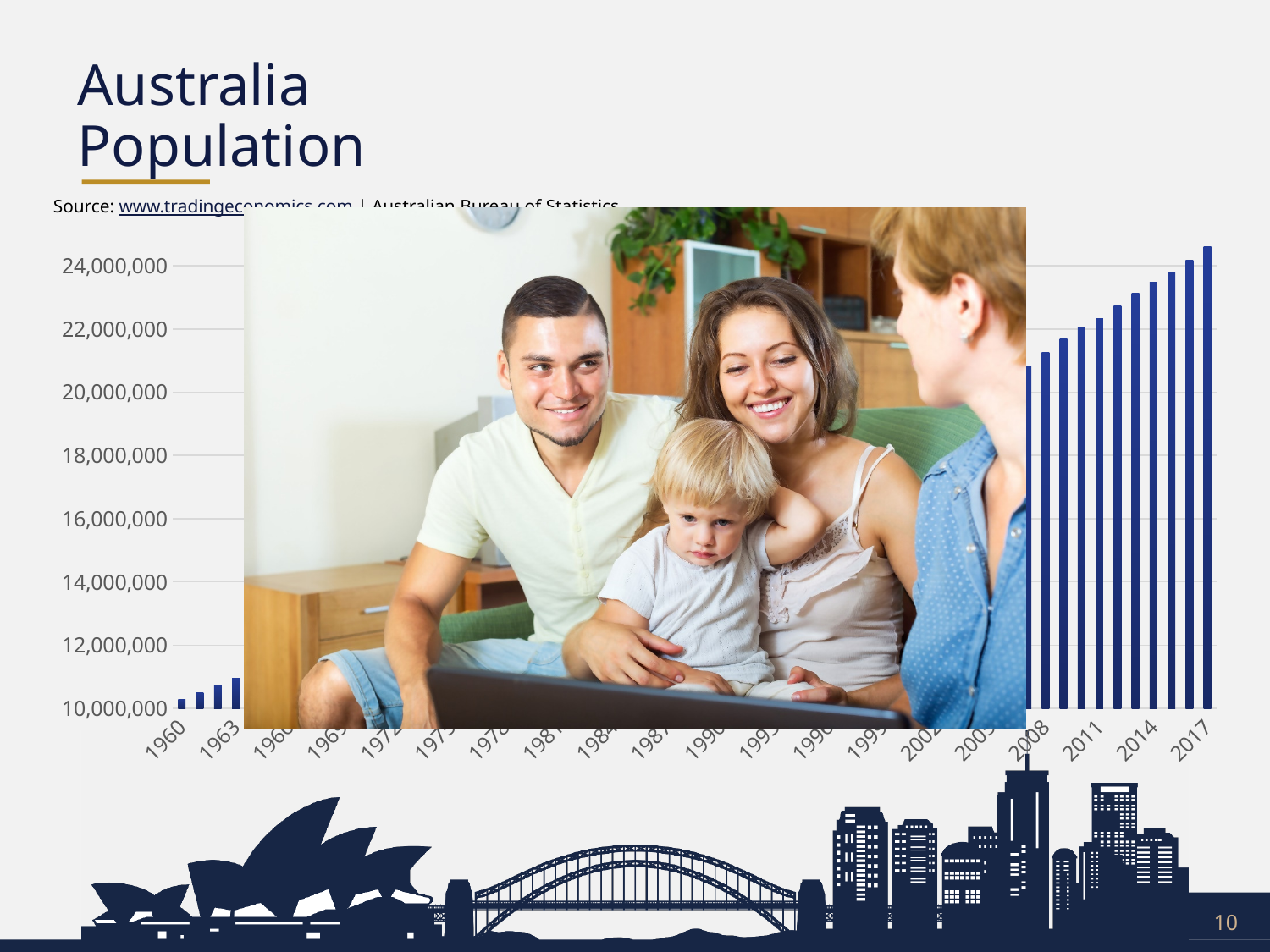
Which is larger, the value for 1960 or the value for 2014? 2014 Which is larger, the value for 2008 or the value for 2017? 2017 Is the value for 2017 greater or less than 24,000,000? greater What is the first year labelled on the x axis? 1960 Is the value for 1960 greater or less than 12,000,000? less What kind of chart is shown on the slide? bar chart What is the highest value labelled on the vertical axis? 24,000,000 Which of the visible years has the highest value? 2017 Is the value for 2008 greater or less than 20,000,000? greater What is the title of the slide's chart? Australia Population Do the values rise or fall from 2008 to 2017 along the x axis? rise